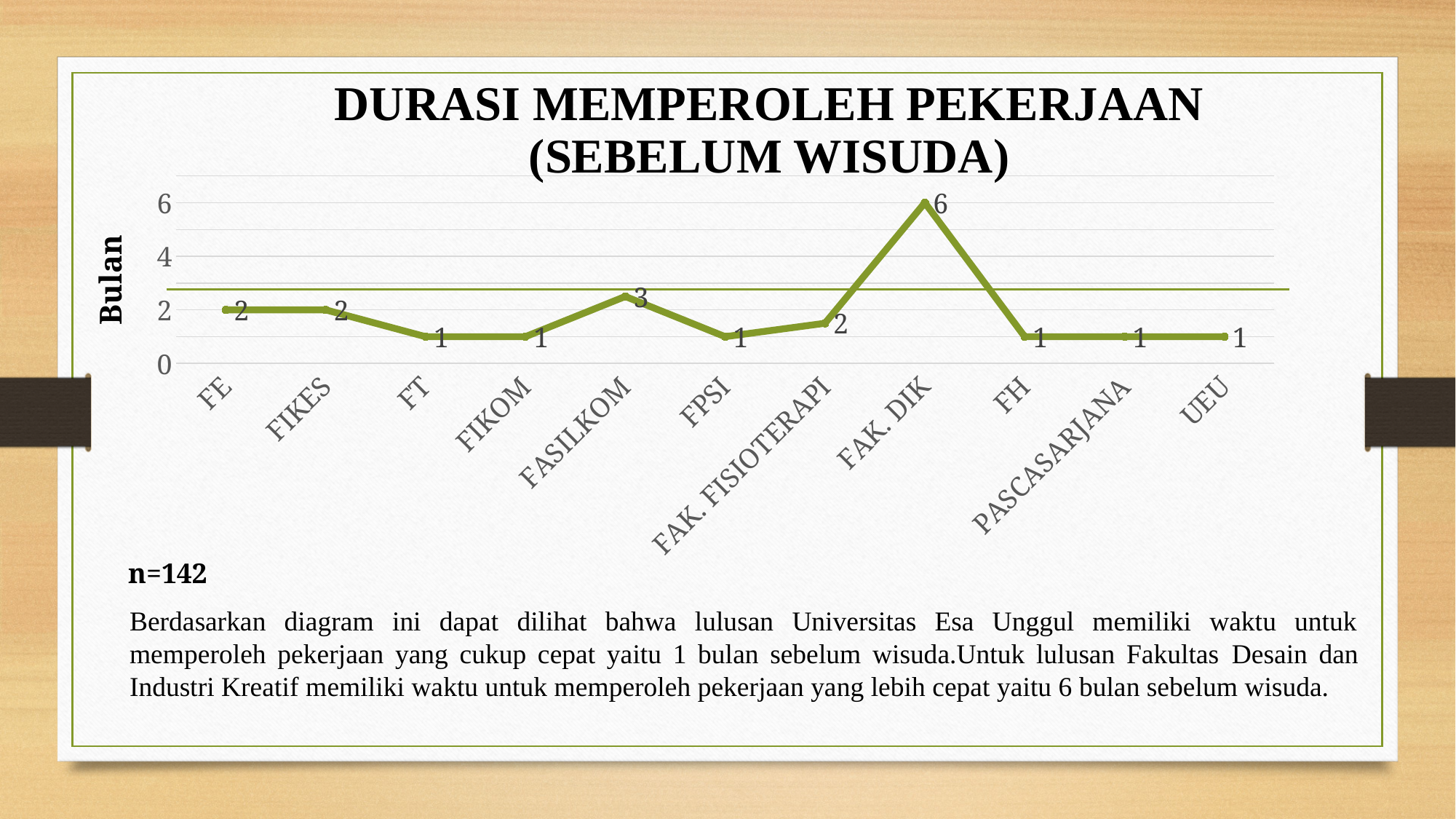
Is the value for FAK. DIK greater or less than 4? greater What is the value for FAK. DIK? 6 What is the value for FE? 2 Which is larger, the value for FIKES or the value for FT? FIKES How many categories are shown on the x axis? 11 Which category has the highest value? FAK. DIK What is the value for FAK. FISIOTERAPI? 2 What is the value for UEU? 1 What is the label of the vertical axis? Bulan What is the difference between the values for FAK. DIK and FASILKOM? 3 What is the value for FASILKOM? 3 What type of chart is shown on the slide? line chart